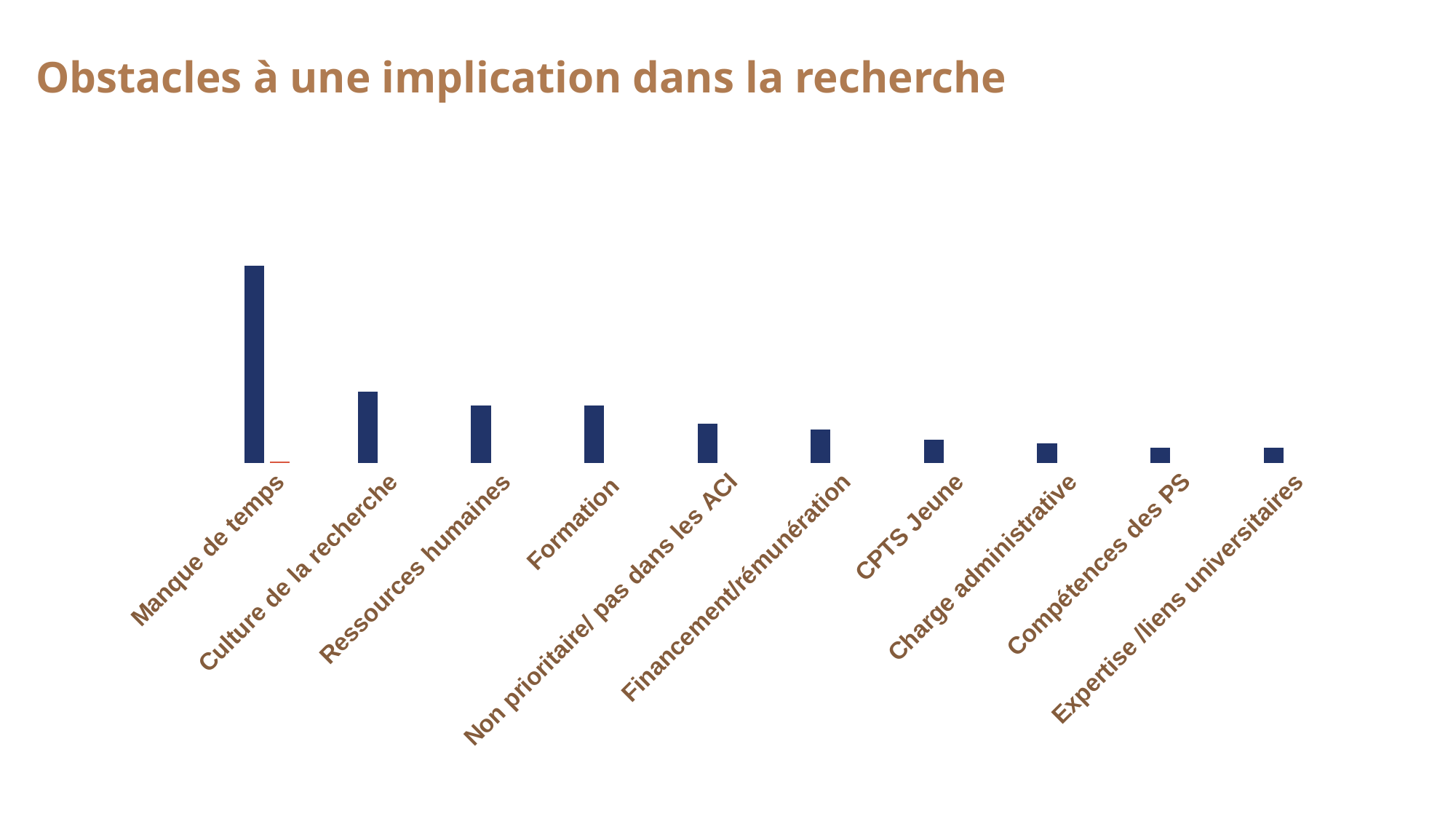
How many categories are plotted in the chart? 10 Which is larger, the value for Manque de temps or the value for Culture de la recherche? Manque de temps Which is larger, the value for Ressources humaines or the value for CPTS Jeune? Ressources humaines What is the label of the first category on the left of the x axis? Manque de temps Which category has the highest bar? Manque de temps What is the title of the chart? Obstacles à une implication dans la recherche Which is larger, the value for Charge administrative or the value for Manque de temps? Manque de temps Do the bar values rise or fall from left to right along the x axis? Fall What kind of chart is shown on the slide? Bar chart